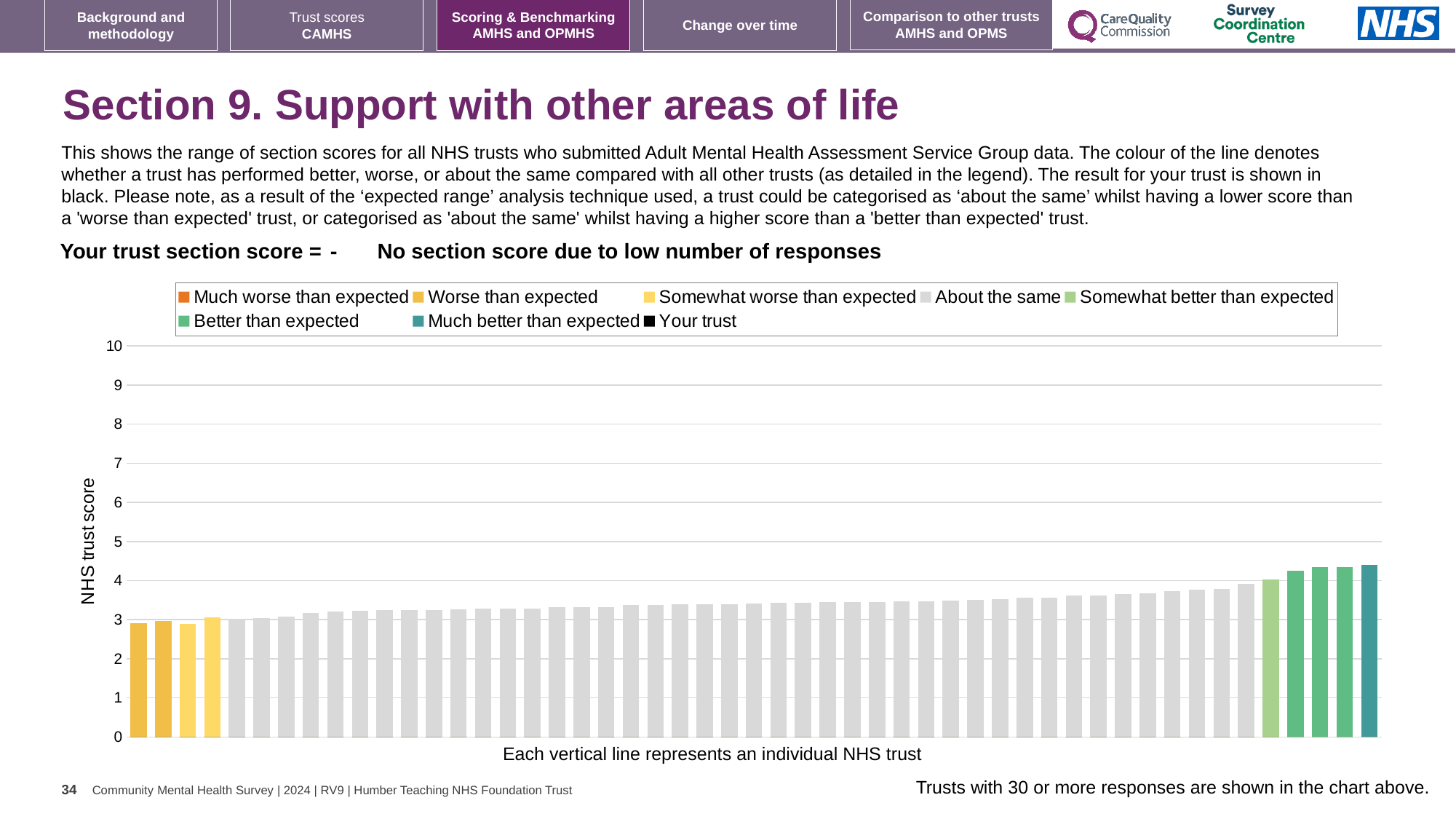
What is the label on the vertical axis of the chart? NHS trust score Is the value of the leftmost bar greater or less than 4? less Is the value of the shortest bar greater or less than 2? greater Is the value of the rightmost bar greater or less than 4? greater What is the highest value shown on the vertical axis of the chart? 10 Do the bar values rise or fall from left to right across the chart? rise How many entries does the chart legend list? 8 What kind of chart is shown on the slide? bar chart